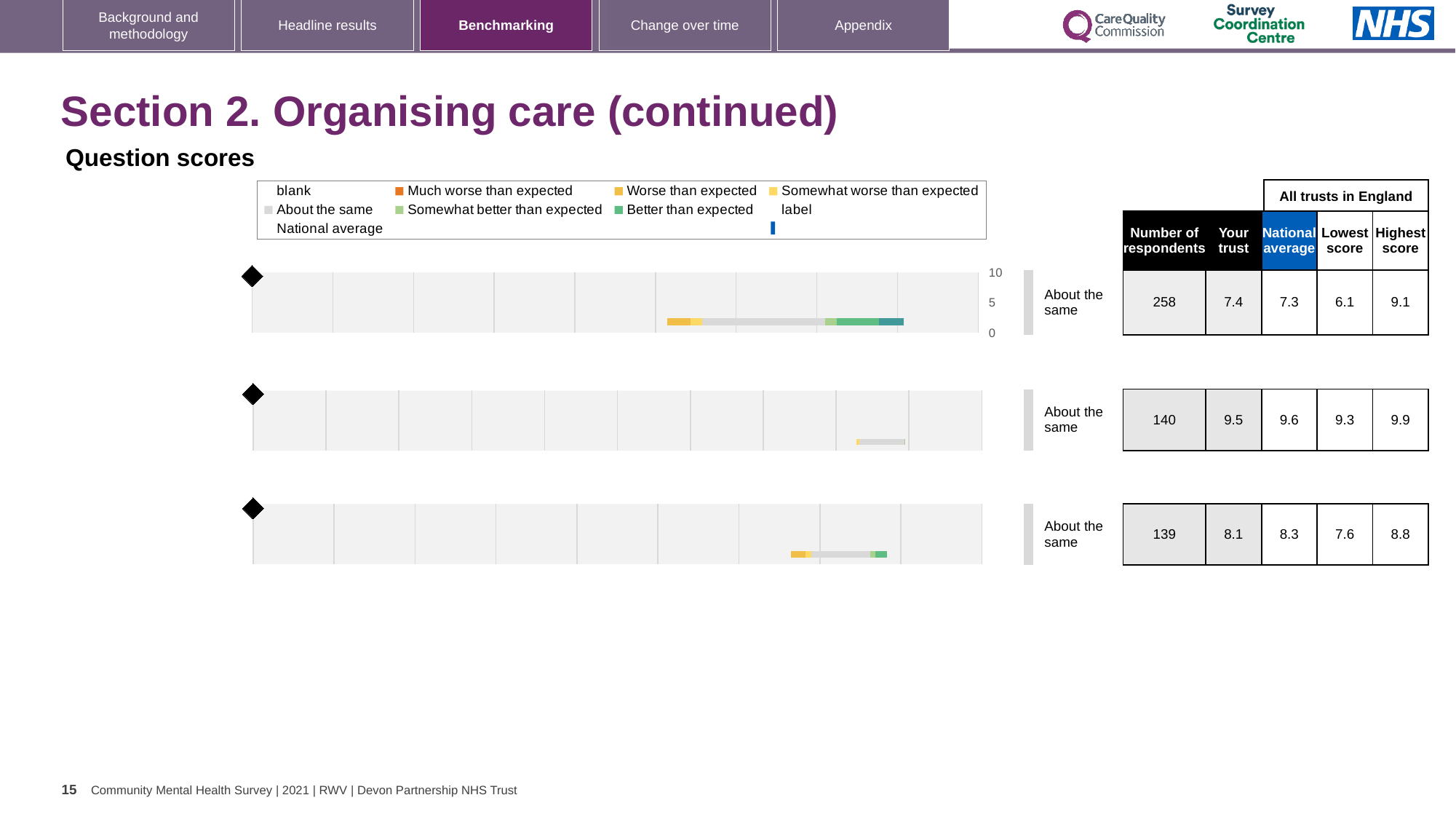
What kind of chart is used for the benchmarking displays on the slide? bar chart What is the highest tick value shown on the vertical axis of the top chart? 10 How many benchmarking charts are shown on the slide? 3 For the top chart, which is larger: the 'Your trust' score or the national average? Your trust What benchmarking category label is shown beside the bottom chart? About the same For the bottom chart, what is the highest score across all trusts in England? 8.8 For the top chart, what is the number of respondents shown in the table? 258 For the top chart, what is the 'Your trust' score shown in the table? 7.4 Which legend entry is shown in orange? Much worse than expected For the bottom chart, which is larger: the 'Your trust' score or the national average? National average For the middle chart, what is the difference between the highest score and the lowest score across all trusts in England? 0.6 For the middle chart, what is the national average shown in the table? 9.6